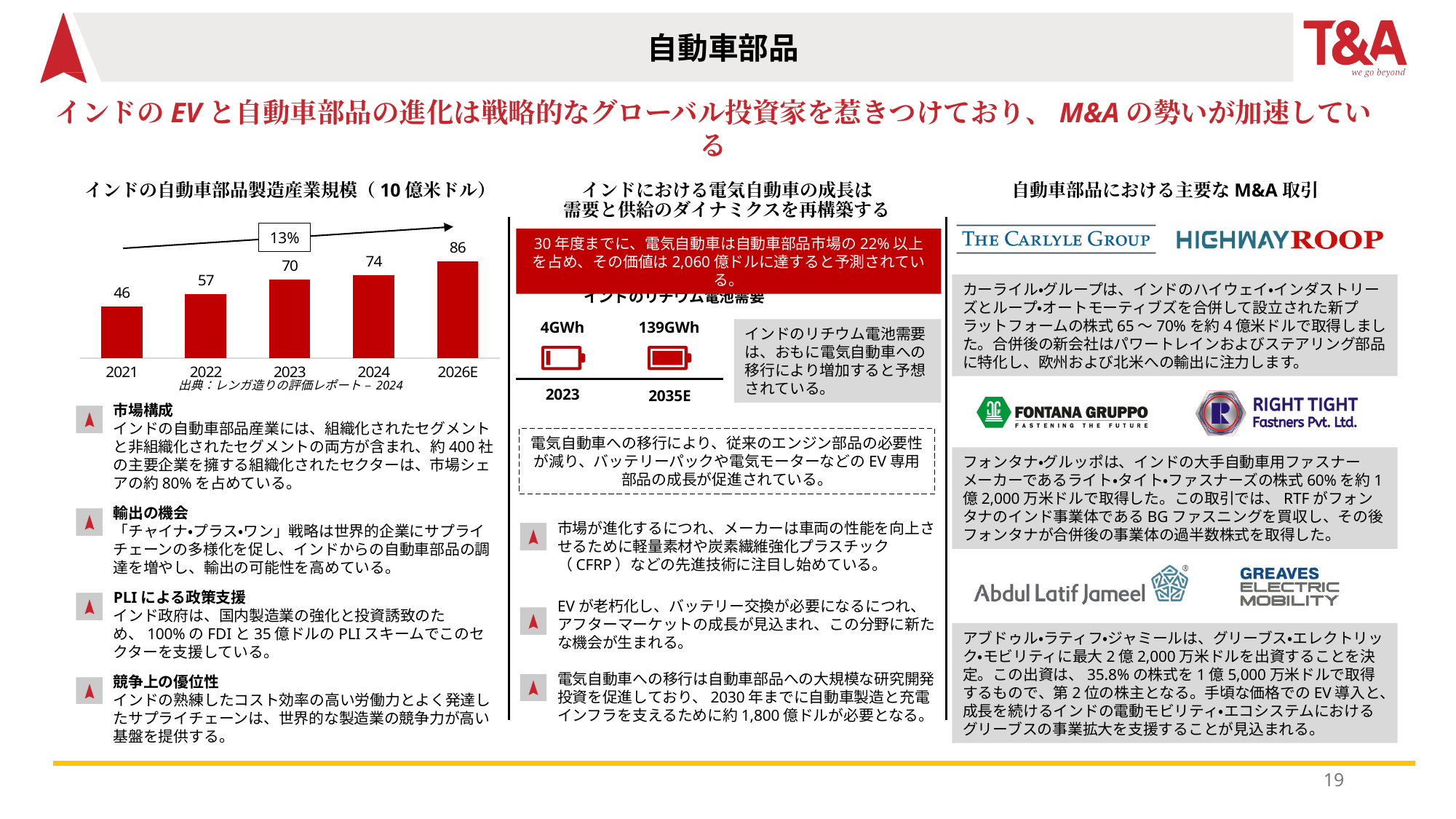
In the chart インドの自動車部品製造産業規模, what is the value for 2026E? 86 In the chart インドの自動車部品製造産業規模, which year has the highest value? 2026E In the chart インドの自動車部品製造産業規模, which year has the lowest value? 2021 What type of chart is used to show India's auto component manufacturing industry size (インドの自動車部品製造産業規模)? bar chart In the chart インドの自動車部品製造産業規模, what is the value for 2021? 46 Do the values in the chart インドの自動車部品製造産業規模 rise or fall from 2021 to 2026E? rise In the chart インドの自動車部品製造産業規模, which is larger, the value for 2022 or the value for 2024? 2024 How many bars (years) are shown in the chart インドの自動車部品製造産業規模? 5 What growth rate is shown in the annotation box above the bars in the chart インドの自動車部品製造産業規模? 13% In the chart インドの自動車部品製造産業規模, what is the difference between the values for 2026E and 2021? 40 In the chart インドの自動車部品製造産業規模, what is the difference between the values for 2024 and 2023? 4 In the chart インドの自動車部品製造産業規模, what is the value for 2023? 70